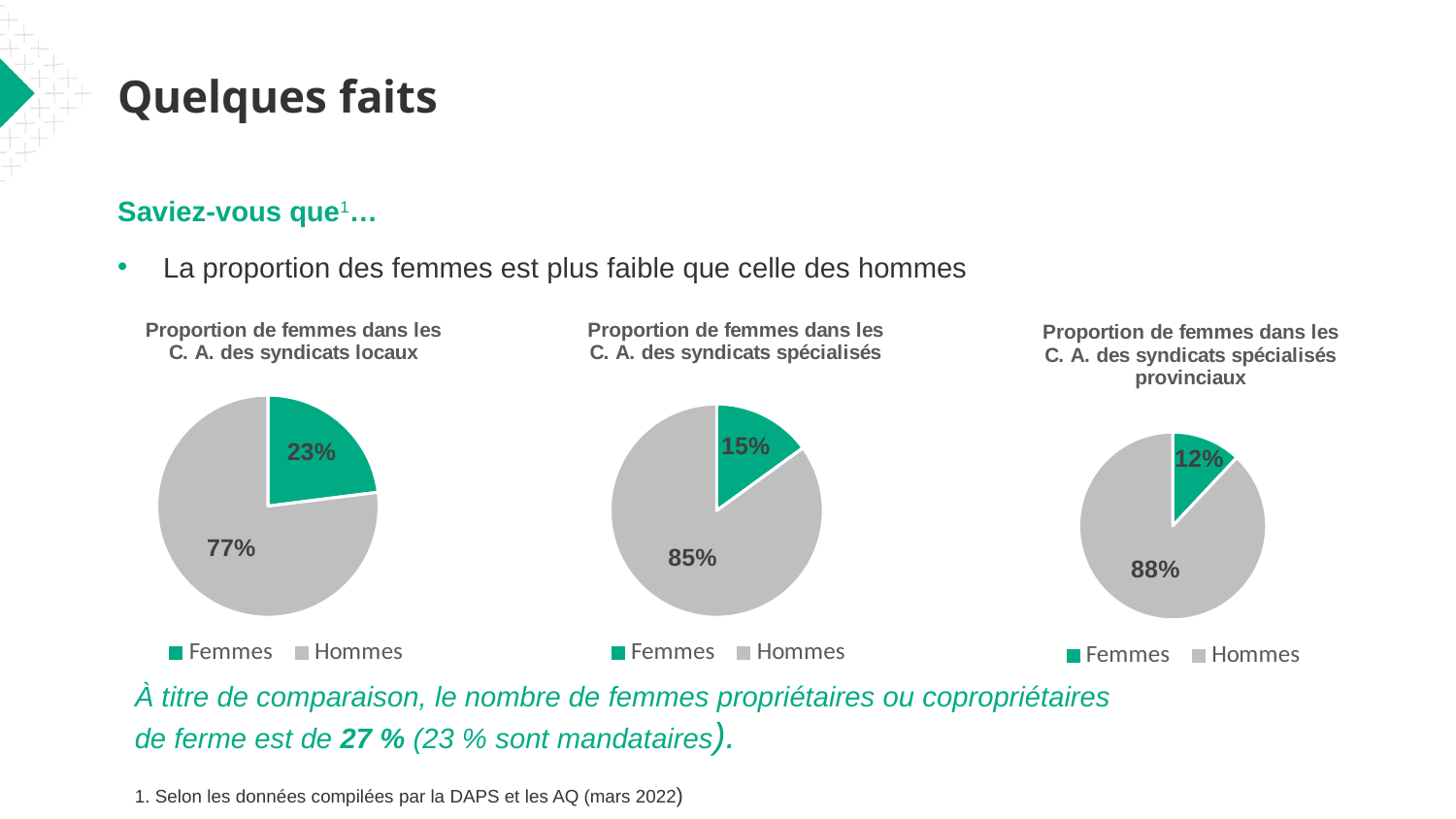
In the chart titled 'Proportion de femmes dans les C. A. des syndicats spécialisés', which category has the largest slice? Hommes In the chart titled 'Proportion de femmes dans les C. A. des syndicats locaux', what percentage is shown for Hommes? 77% In the chart titled 'Proportion de femmes dans les C. A. des syndicats spécialisés', what percentage is shown for Femmes? 15% Which chart shows a larger Femmes share: 'Proportion de femmes dans les C. A. des syndicats locaux' or 'Proportion de femmes dans les C. A. des syndicats spécialisés provinciaux'? Proportion de femmes dans les C. A. des syndicats locaux In the chart titled 'Proportion de femmes dans les C. A. des syndicats locaux', what colour is the Femmes slice? Green What kind of chart is the leftmost chart on the slide? Pie chart In the chart titled 'Proportion de femmes dans les C. A. des syndicats spécialisés provinciaux', what percentage is shown for Femmes? 12% In the chart titled 'Proportion de femmes dans les C. A. des syndicats spécialisés provinciaux', what percentage is shown for Hommes? 88% How many categories does the legend list in the chart titled 'Proportion de femmes dans les C. A. des syndicats spécialisés provinciaux'? 2 In the chart titled 'Proportion de femmes dans les C. A. des syndicats locaux', what percentage is shown for Femmes? 23% In the chart titled 'Proportion de femmes dans les C. A. des syndicats spécialisés', what is the difference between the Hommes and Femmes percentages? 70% In the chart titled 'Proportion de femmes dans les C. A. des syndicats locaux', which category has the smallest slice? Femmes